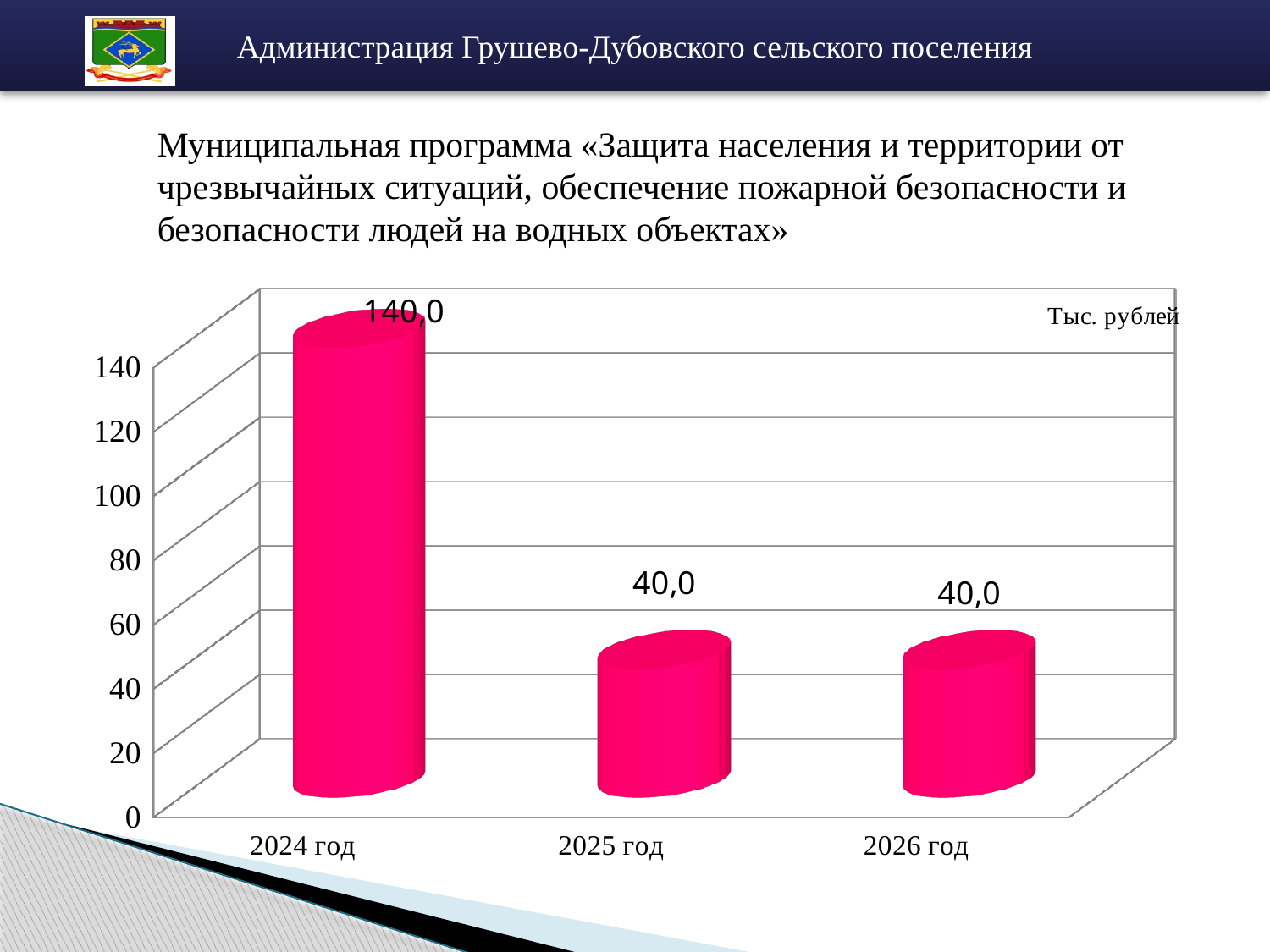
What unit is indicated in the top right corner of the chart? Тыс. рублей Is the value for 2025 год greater or less than 60? less What is the value for 2026 год? 40,0 What kind of chart is shown on the slide? bar chart What is the value for 2025 год? 40,0 What is the difference between the values for 2024 год and 2025 год? 100,0 How many years are shown on the x axis? 3 Is the value for 2024 год greater or less than 120? greater Do the values rise or fall from 2024 год to 2025 год? fall Which is larger, the value for 2024 год or the value for 2026 год? 2024 год What is the value for 2024 год? 140,0 Which year has the highest value? 2024 год